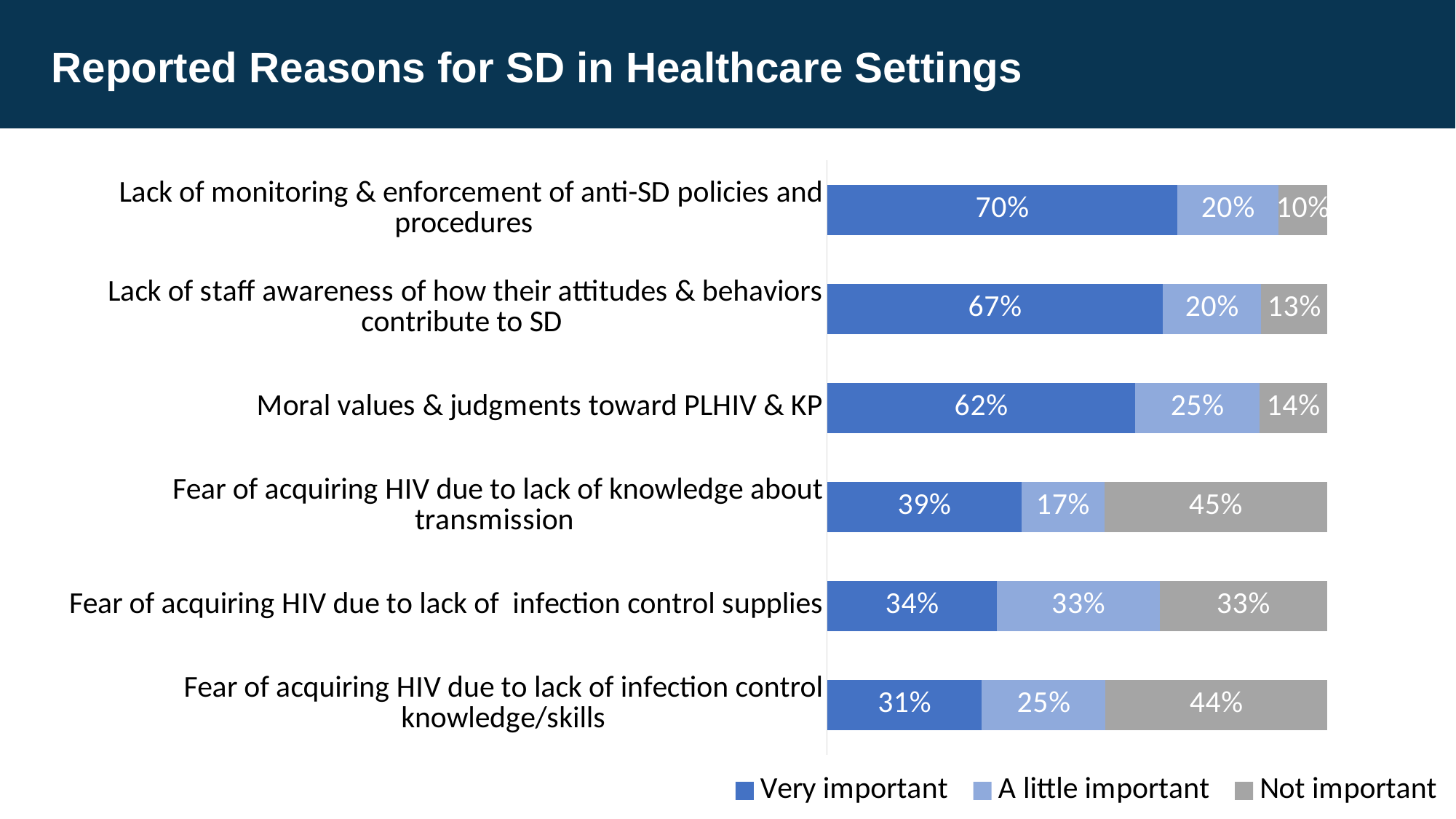
Which is larger: the Not important value for 'Fear of acquiring HIV due to lack of knowledge about transmission' or for 'Fear of acquiring HIV due to lack of infection control supplies'? Fear of acquiring HIV due to lack of knowledge about transmission What percentage rated 'Lack of monitoring & enforcement of anti-SD policies and procedures' as Very important? 70% Which legend entry is shown in grey? Not important What kind of chart is shown on the slide? Stacked bar chart What is the title of the chart on the slide? Reported Reasons for SD in Healthcare Settings How many series does the legend list? 3 What is the Not important value for 'Fear of acquiring HIV due to lack of knowledge about transmission'? 45% Which reason has the lowest Very important percentage? Fear of acquiring HIV due to lack of infection control knowledge/skills Which reason has the highest Very important percentage? Lack of monitoring & enforcement of anti-SD policies and procedures What is the A little important value for 'Moral values & judgments toward PLHIV & KP'? 25% How many reasons (categories) are shown in the chart? 6 What is the difference between the Very important values for 'Lack of staff awareness of how their attitudes & behaviors contribute to SD' and 'Moral values & judgments toward PLHIV & KP'? 5%